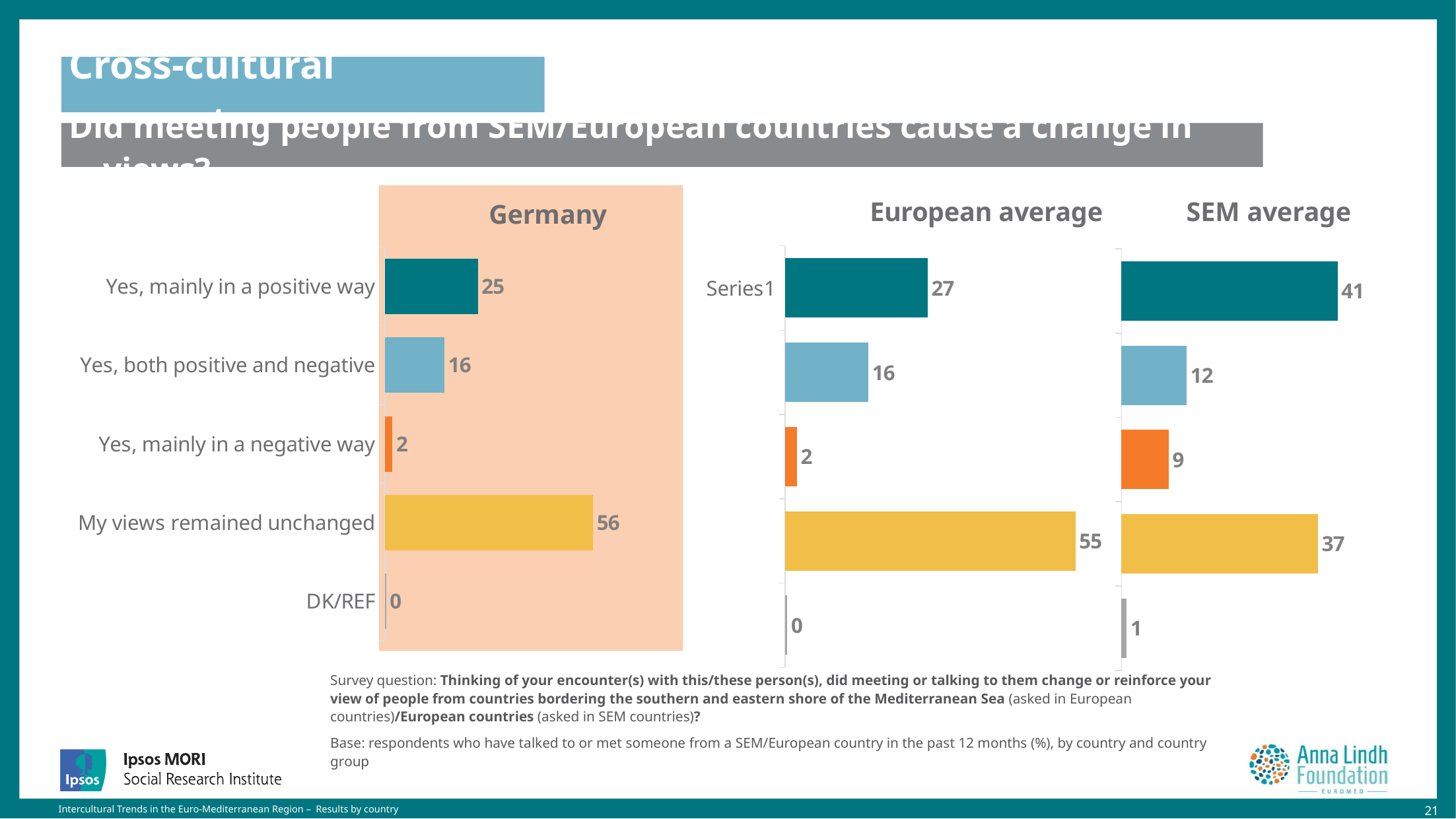
In the Germany chart, what is the value for 'Yes, mainly in a positive way'? 25 In the SEM average chart, what is the value of the top (dark teal) bar? 41 In the SEM average chart, what is the difference between the top bar (41) and the yellow bar (37)? 4 In the Germany chart, what is the difference between 'My views remained unchanged' and 'Yes, mainly in a positive way'? 31 In the Germany chart, which is larger: 'Yes, both positive and negative' or 'Yes, mainly in a negative way'? Yes, both positive and negative In the Germany chart, what is the value for 'My views remained unchanged'? 56 What type of chart is used for Germany? Bar chart In the European average chart, what is the highest value shown? 55 In the Germany chart, which category has the highest value? My views remained unchanged In the Germany chart, which category has the lowest value? DK/REF How many categories does the Germany chart show? 5 Which chart has the larger value for its orange bar: European average or SEM average? SEM average